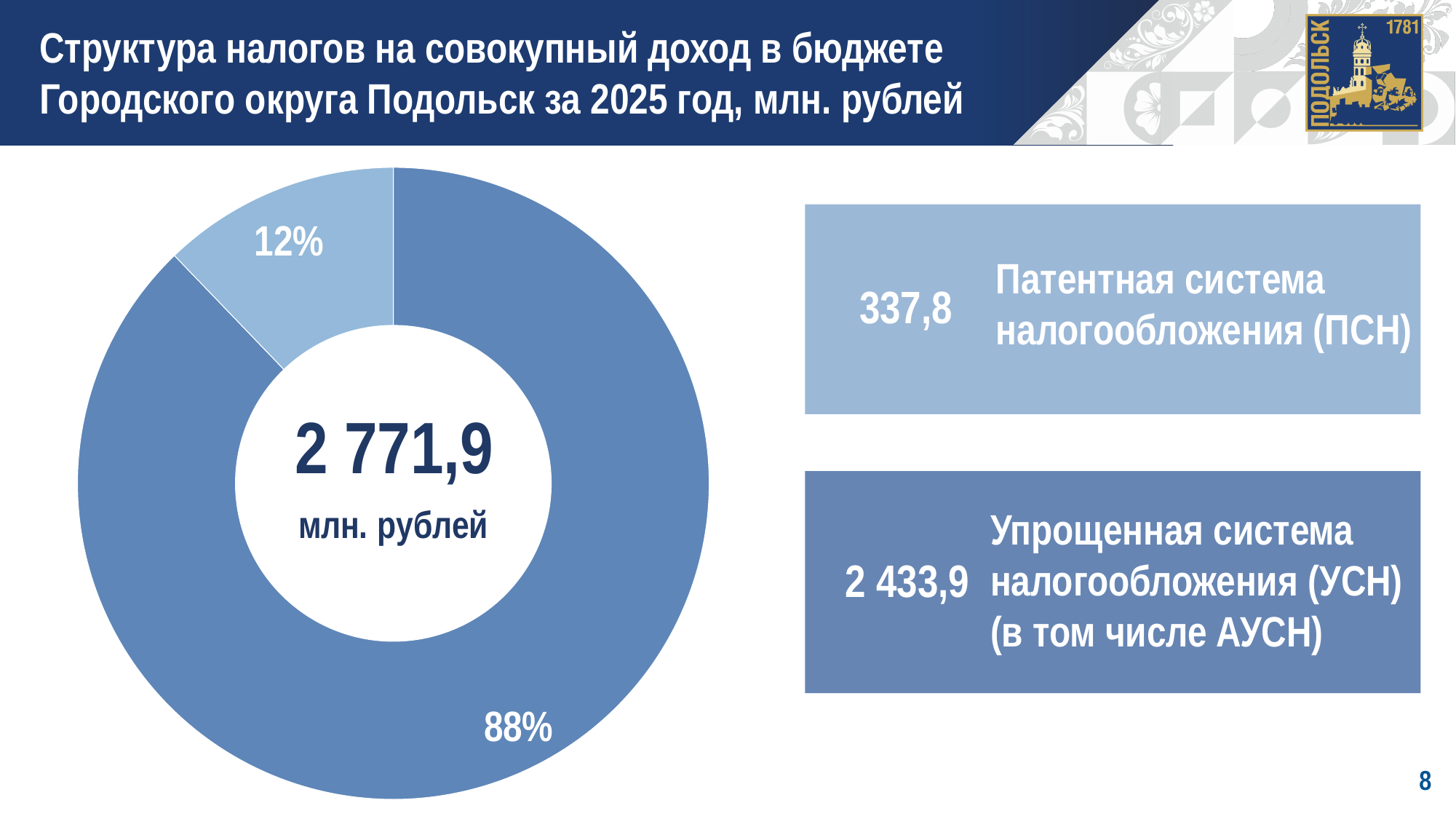
What kind of chart is shown on the slide? Pie (donut) chart What is the value for Патентная система налогообложения (ПСН)? 337,8 What is the difference between the УСН value and the ПСН value? 2 096,1 What is the total shown in the centre of the donut chart? 2 771,9 млн. рублей Which category has the smallest share of the pie? Патентная система налогообложения (ПСН) How many categories does the pie chart have? 2 Which category has the largest share of the pie? Упрощенная система налогообложения (УСН) Which is larger, the value for УСН or the value for ПСН? УСН What is the value for Упрощенная система налогообложения (УСН) (в том числе АУСН)? 2 433,9 What share of the pie does the Патентная система налогообложения (ПСН) slice represent? 12% What share of the pie does the Упрощенная система налогообложения (УСН) slice represent? 88% What is the title of the slide? Структура налогов на совокупный доход в бюджете Городского округа Подольск за 2025 год, млн. рублей